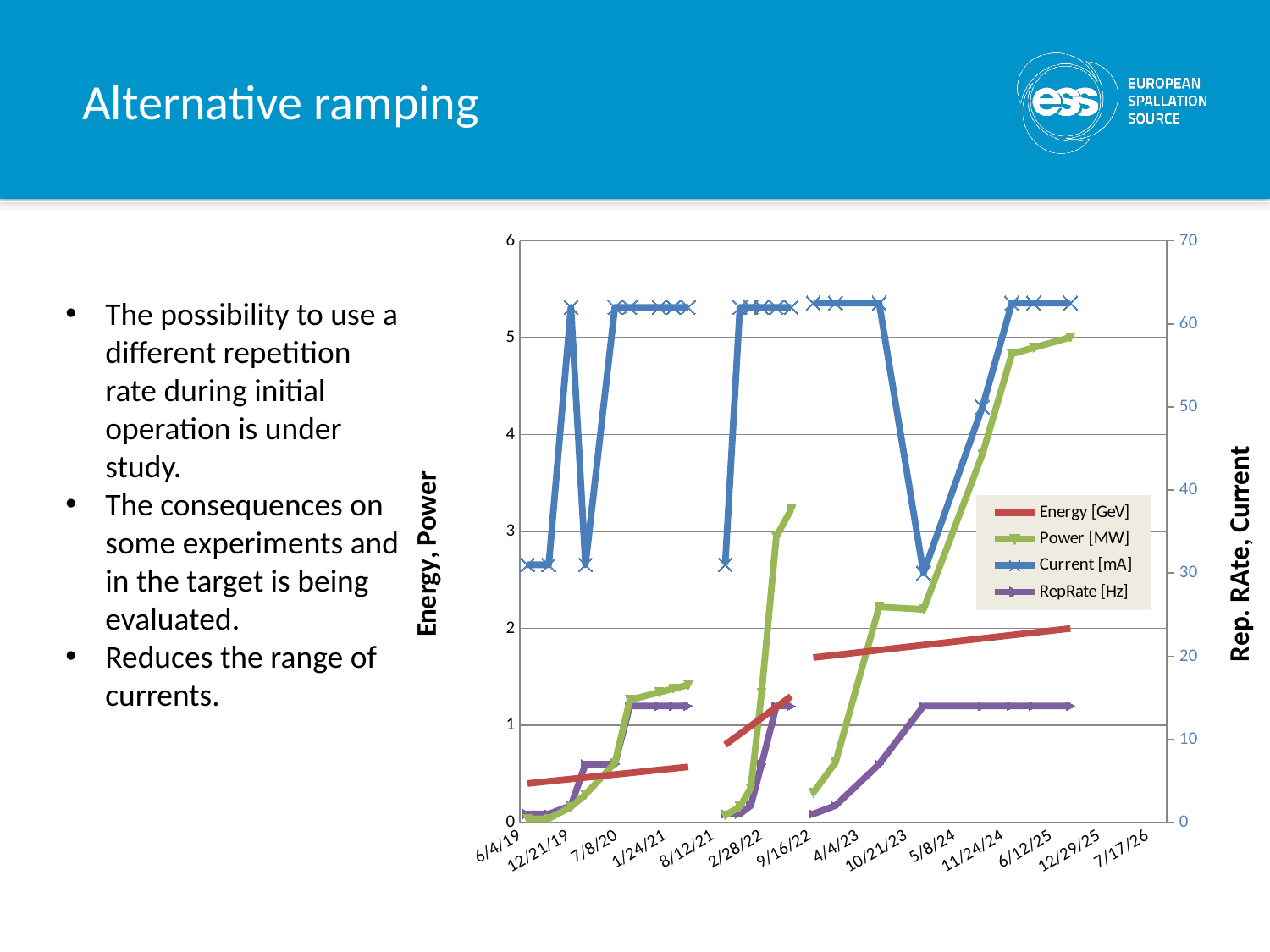
Is the RepRate [Hz] value around 6/12/25 greater or less than 20 on the right axis? less How many series does the chart's legend list? 4 What kind of chart is shown on the slide? line chart At the right end of the chart, which series is higher on the left axis, Power [MW] or Energy [GeV]? Power [MW] What are the four series listed in the chart's legend? Energy [GeV], Power [MW], Current [mA], RepRate [Hz] Does the Energy [GeV] series rise or fall over time along the x axis? rise Is the Current [mA] value around 1/24/21 greater or less than 50 on the right axis? greater Which of the two left-axis series, Energy [GeV] or Power [MW], reaches the highest value on the chart? Power [MW] Is the Energy [GeV] value around 7/8/20 greater or less than 1 on the left axis? less What is the title of the right-hand vertical axis of the chart? Rep. RAte, Current